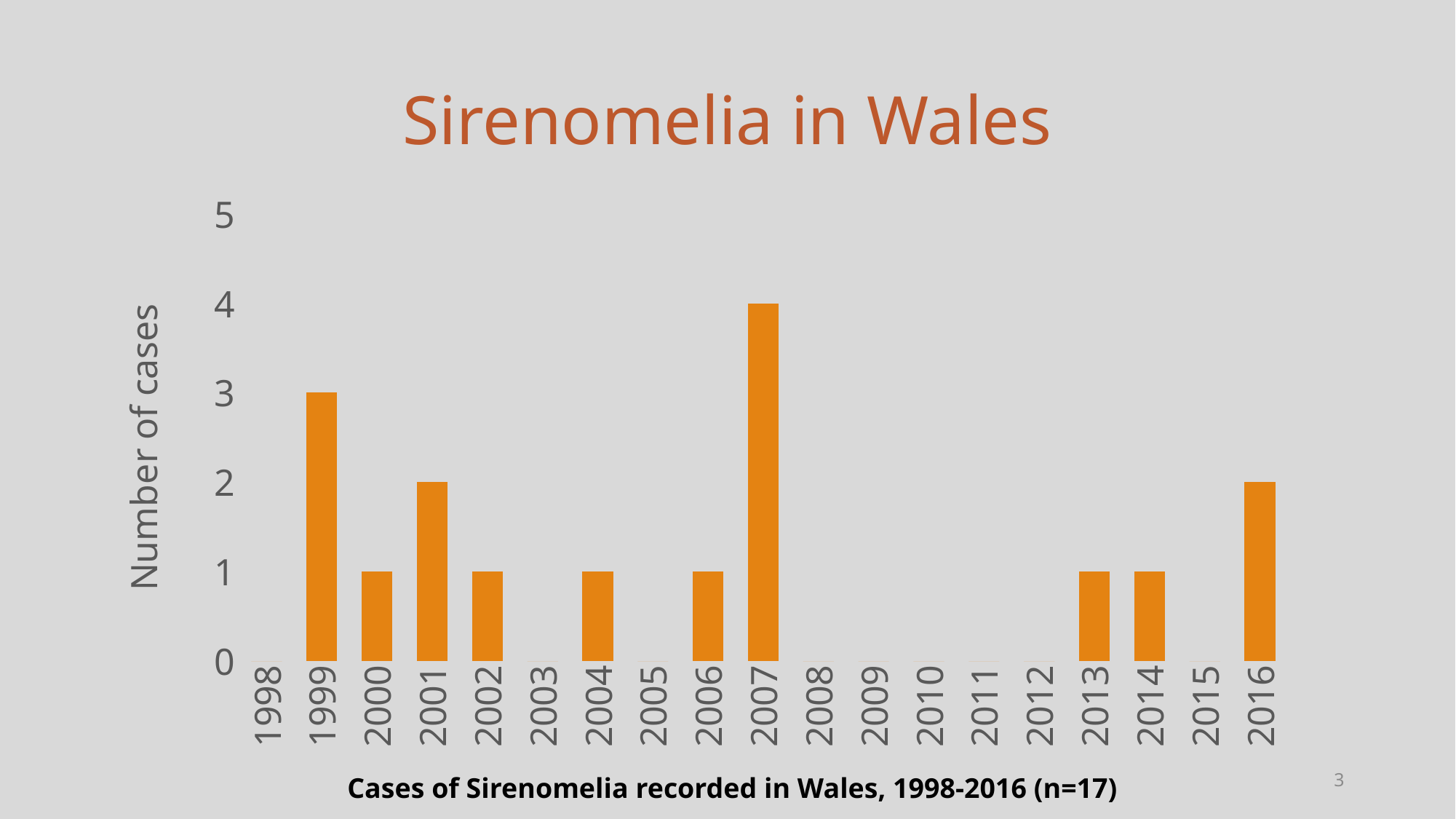
Which year has the highest number of cases? 2007 What is the difference in the number of cases between 2007 and 1999? 1 How many cases were recorded in 2013? 1 What kind of chart is shown on the slide? bar chart What is the label of the y axis? Number of cases What is the caption below the chart? Cases of Sirenomelia recorded in Wales, 1998-2016 (n=17) How many cases were recorded in 2007? 4 How many cases were recorded in 2016? 2 How many cases were recorded in 1999? 3 Is the value for 2007 greater or less than 3? greater Which year had more cases, 2001 or 2002? 2001 How many years are shown on the x axis? 19